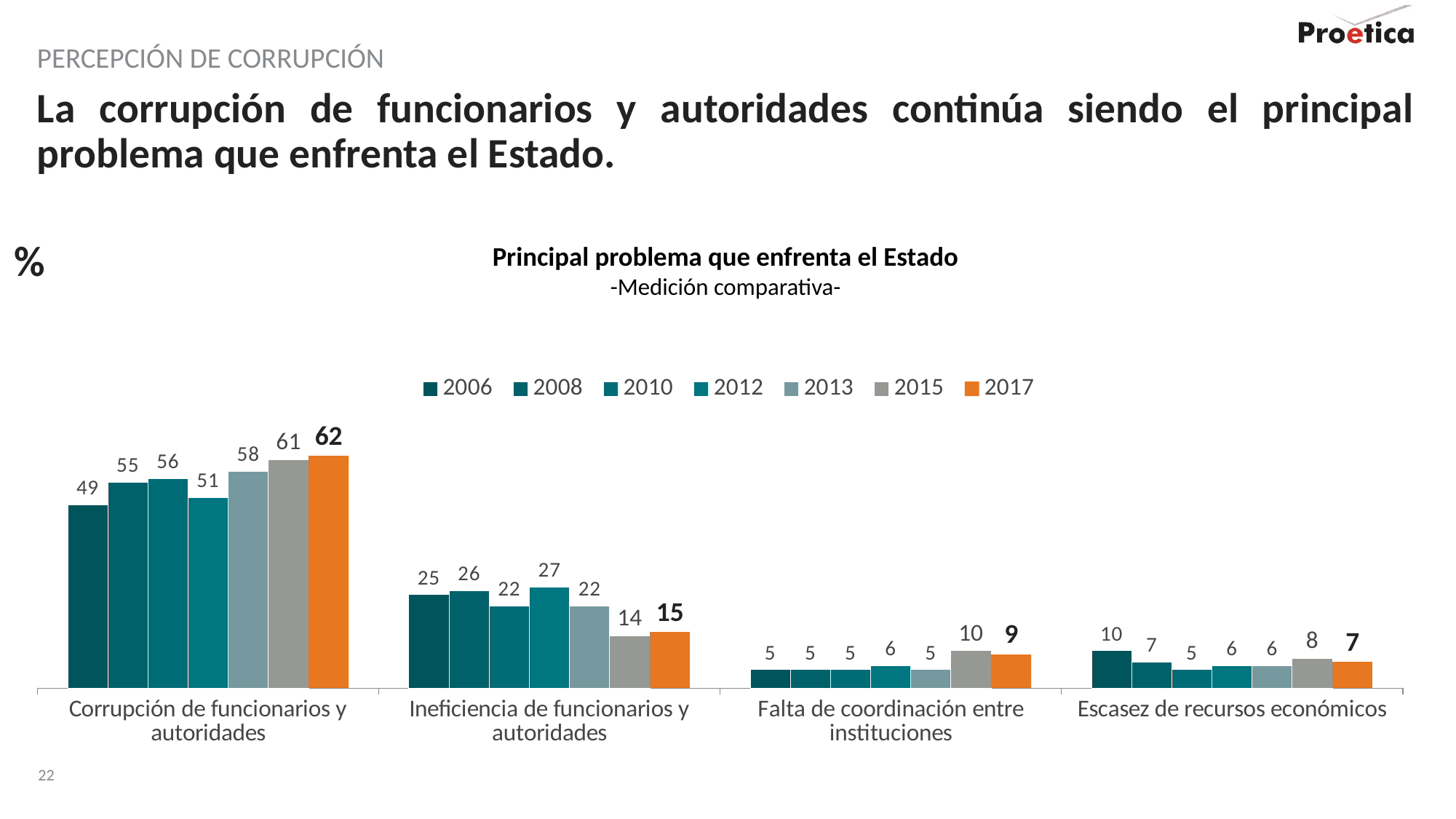
Which year has the highest value for 'Corrupción de funcionarios y autoridades'? 2017 Which year has the lowest value for 'Ineficiencia de funcionarios y autoridades'? 2015 How many categories are shown on the x axis? 4 What is the value for 'Falta de coordinación entre instituciones' in 2015? 10 What is the title of the chart? Principal problema que enfrenta el Estado -Medición comparativa- Which is larger for 2017: 'Falta de coordinación entre instituciones' or 'Escasez de recursos económicos'? Falta de coordinación entre instituciones What is the difference between the 2017 and 2006 values for 'Corrupción de funcionarios y autoridades'? 13 What is the value for 'Ineficiencia de funcionarios y autoridades' in 2012? 27 What kind of chart is shown on the slide? Bar chart What is the value for 'Corrupción de funcionarios y autoridades' in 2017? 62 How many series does the legend list? 7 What is the value for 'Escasez de recursos económicos' in 2006? 10